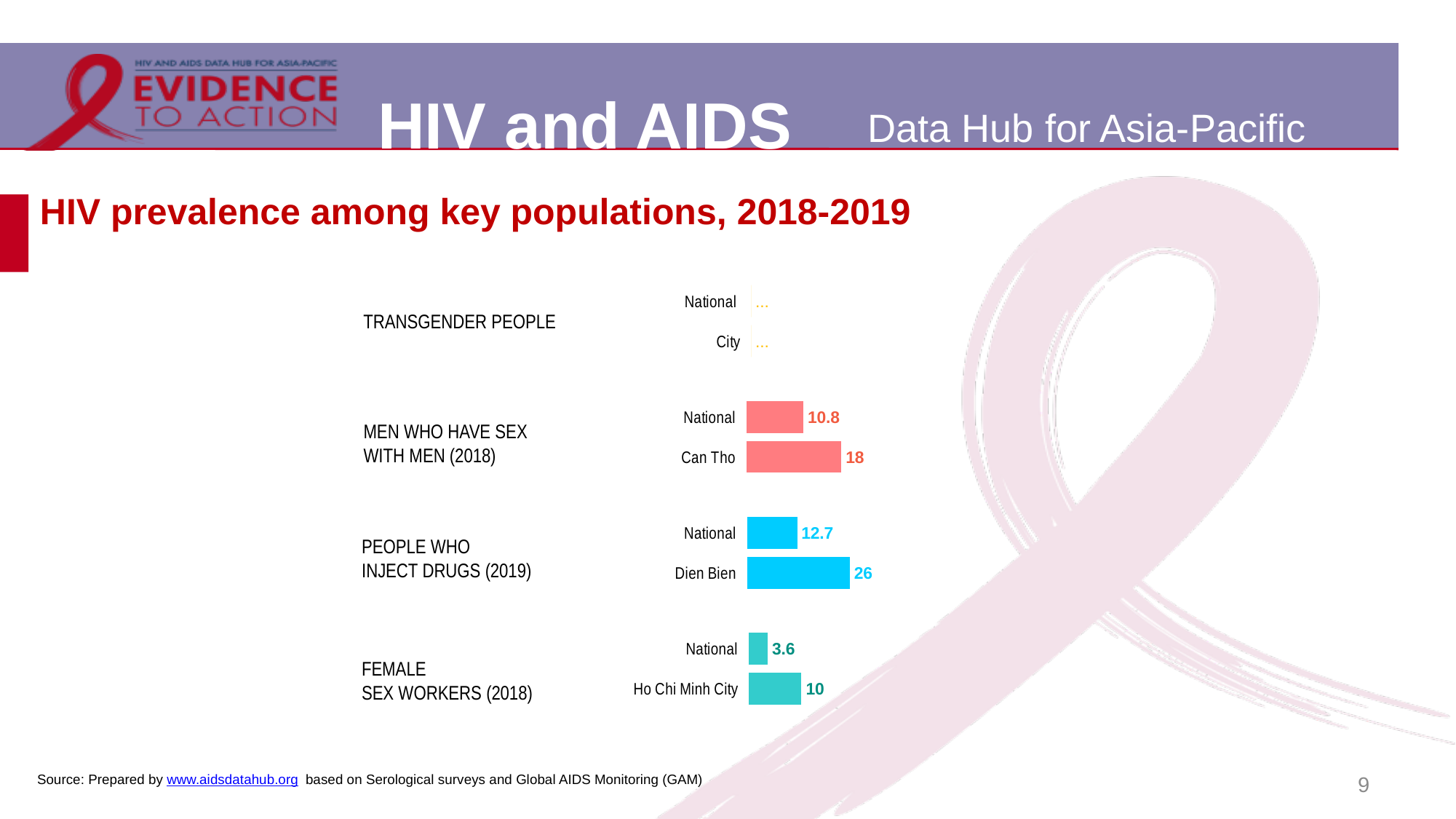
What is the difference between the Dien Bien value and the national value for people who inject drugs? 13.3 What values are shown for transgender people on the chart? None; both National and City show "..." Which plotted value on the chart is the highest? Dien Bien (people who inject drugs), 26 What is the HIV prevalence among people who inject drugs in Dien Bien? 26 What is the national HIV prevalence among people who inject drugs (2019)? 12.7 Which plotted value on the chart is the lowest? National female sex workers, 3.6 What type of chart is shown on the slide? Bar chart What is the national HIV prevalence among men who have sex with men (2018)? 10.8 Which is larger: the national value for men who have sex with men or the national value for people who inject drugs? People who inject drugs (12.7) What is the HIV prevalence among female sex workers in Ho Chi Minh City? 10 What is the difference between the Can Tho value and the national value for men who have sex with men? 7.2 What is the HIV prevalence among men who have sex with men in Can Tho? 18